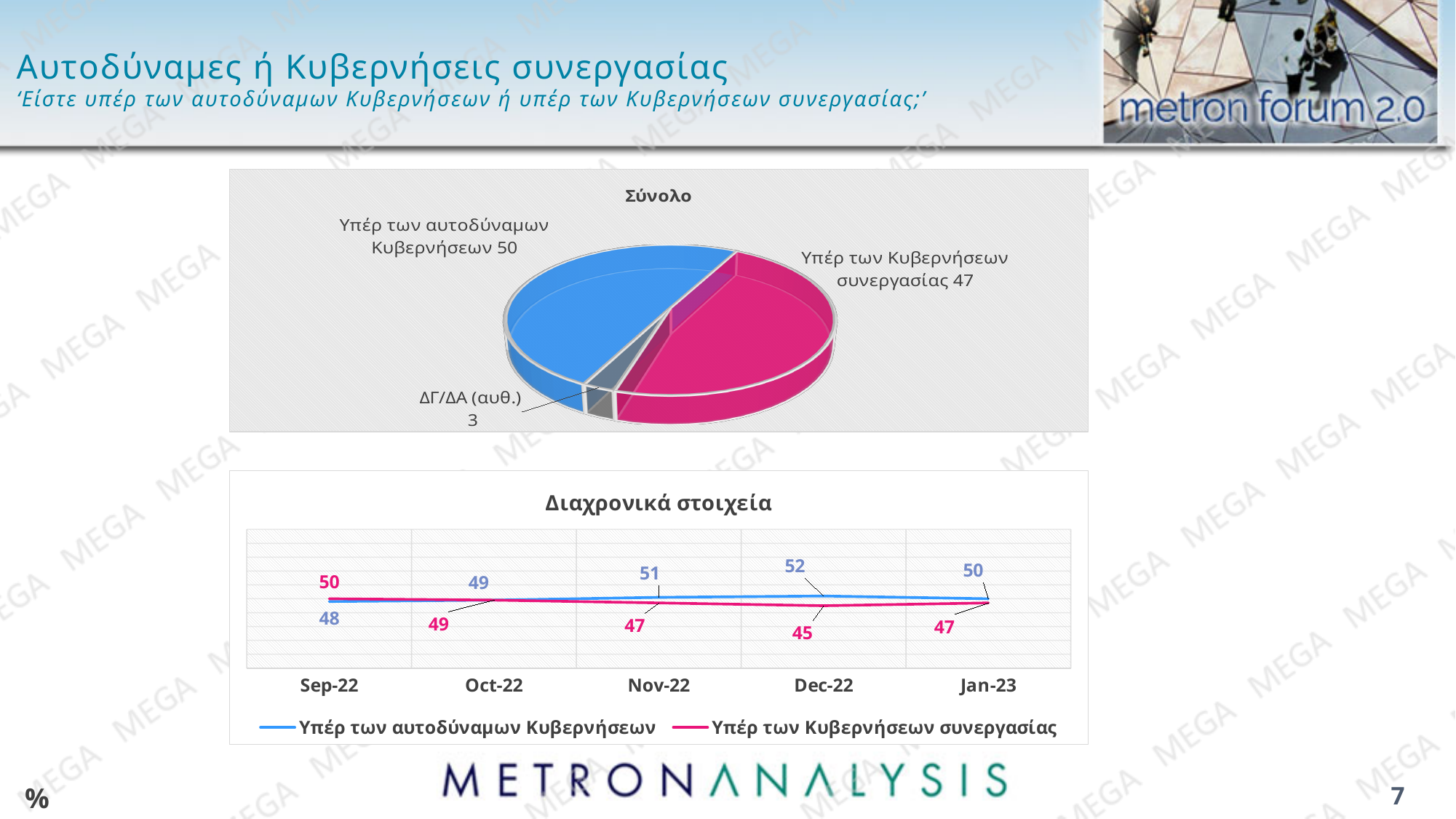
In the 'Διαχρονικά στοιχεία' chart, in which month does 'Υπέρ των Κυβερνήσεων συνεργασίας' reach its lowest value? Dec-22 In the 'Σύνολο' pie chart, what is the difference between 'Υπέρ των αυτοδύναμων Κυβερνήσεων' and 'Υπέρ των Κυβερνήσεων συνεργασίας'? 3 In the 'Διαχρονικά στοιχεία' chart, what is the value for 'Υπέρ των αυτοδύναμων Κυβερνήσεων' in Dec-22? 52 In the 'Σύνολο' pie chart, how many slices are there? 3 In the 'Σύνολο' pie chart, which category has the smallest slice? ΔΓ/ΔΑ (αυθ.) In the 'Διαχρονικά στοιχεία' chart, which series has the higher value in Sep-22? Υπέρ των Κυβερνήσεων συνεργασίας In the 'Διαχρονικά στοιχεία' chart, what is the value for 'Υπέρ των Κυβερνήσεων συνεργασίας' in Sep-22? 50 What kind of chart is 'Διαχρονικά στοιχεία'? Line chart In the 'Διαχρονικά στοιχεία' chart, how many series does the legend list? 2 In the 'Διαχρονικά στοιχεία' chart, what is the difference between the two series in Dec-22? 7 In the 'Σύνολο' pie chart, what is the value for 'Υπέρ των αυτοδύναμων Κυβερνήσεων'? 50 In the 'Σύνολο' pie chart, what is the value for 'ΔΓ/ΔΑ (αυθ.)'? 3